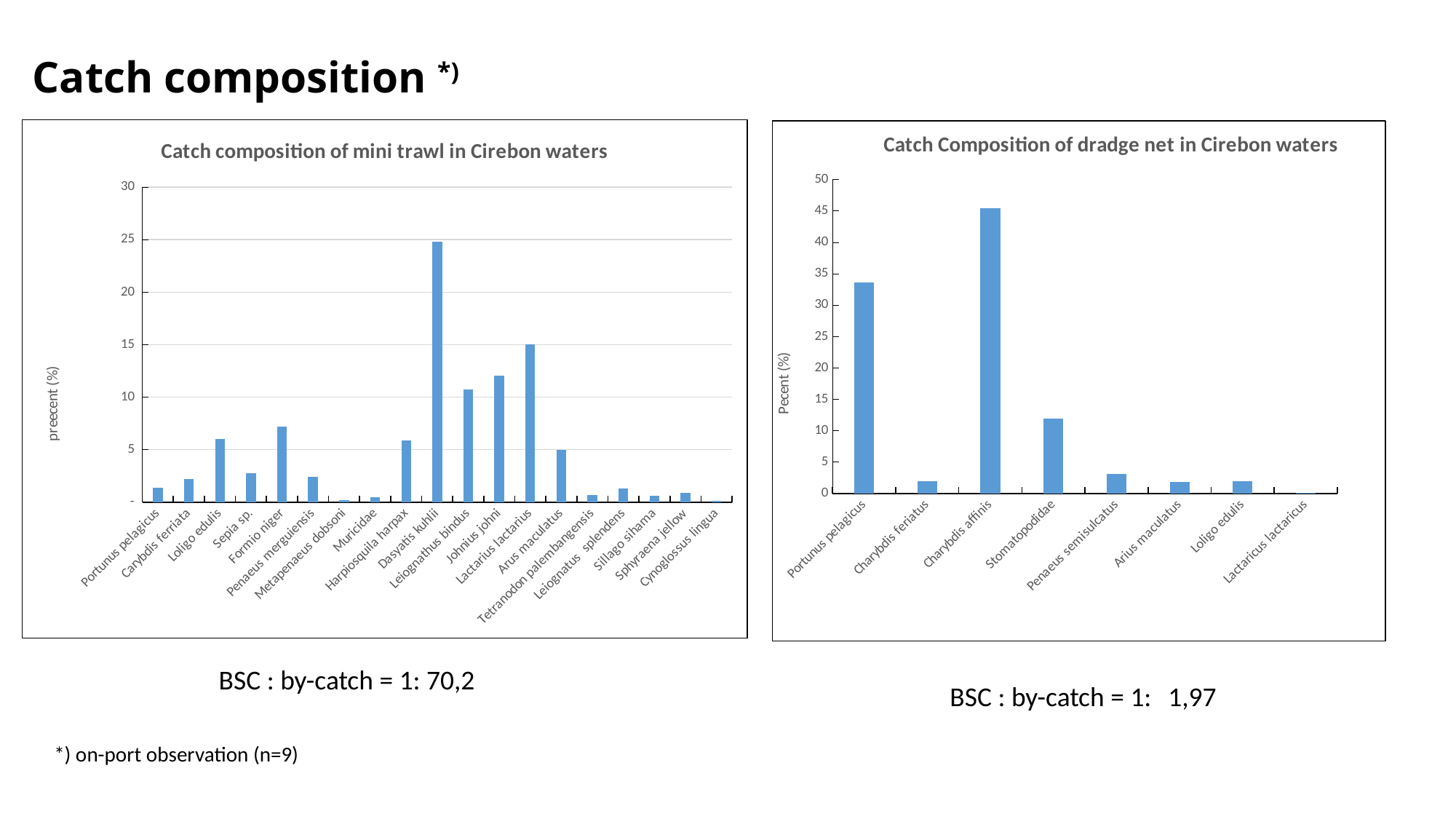
On the chart titled 'Catch Composition of dradge net in Cirebon waters', is the value for Portunus pelagicus greater or less than 30? greater On the chart titled 'Catch composition of mini trawl in Cirebon waters', which category has the highest value? Dasyatis kuhlii How many categories are shown on the chart titled 'Catch Composition of dradge net in Cirebon waters'? 8 On the chart titled 'Catch Composition of dradge net in Cirebon waters', which category has the lowest value? Lactaricus lactaricus On the chart titled 'Catch composition of mini trawl in Cirebon waters', is the value for Dasyatis kuhlii greater or less than 20? greater On the chart titled 'Catch composition of mini trawl in Cirebon waters', is the value for Johnius johni greater or less than 10? greater What kind of chart is the chart titled 'Catch composition of mini trawl in Cirebon waters'? bar chart What is the y-axis label on the chart titled 'Catch Composition of dradge net in Cirebon waters'? Pecent (%) On the chart titled 'Catch Composition of dradge net in Cirebon waters', which is larger, the value for Portunus pelagicus or the value for Charybdis affinis? Charybdis affinis On the chart titled 'Catch composition of mini trawl in Cirebon waters', which is larger, the value for Johnius johni or the value for Lactarius lactarius? Lactarius lactarius On the chart titled 'Catch Composition of dradge net in Cirebon waters', which category has the highest value? Charybdis affinis